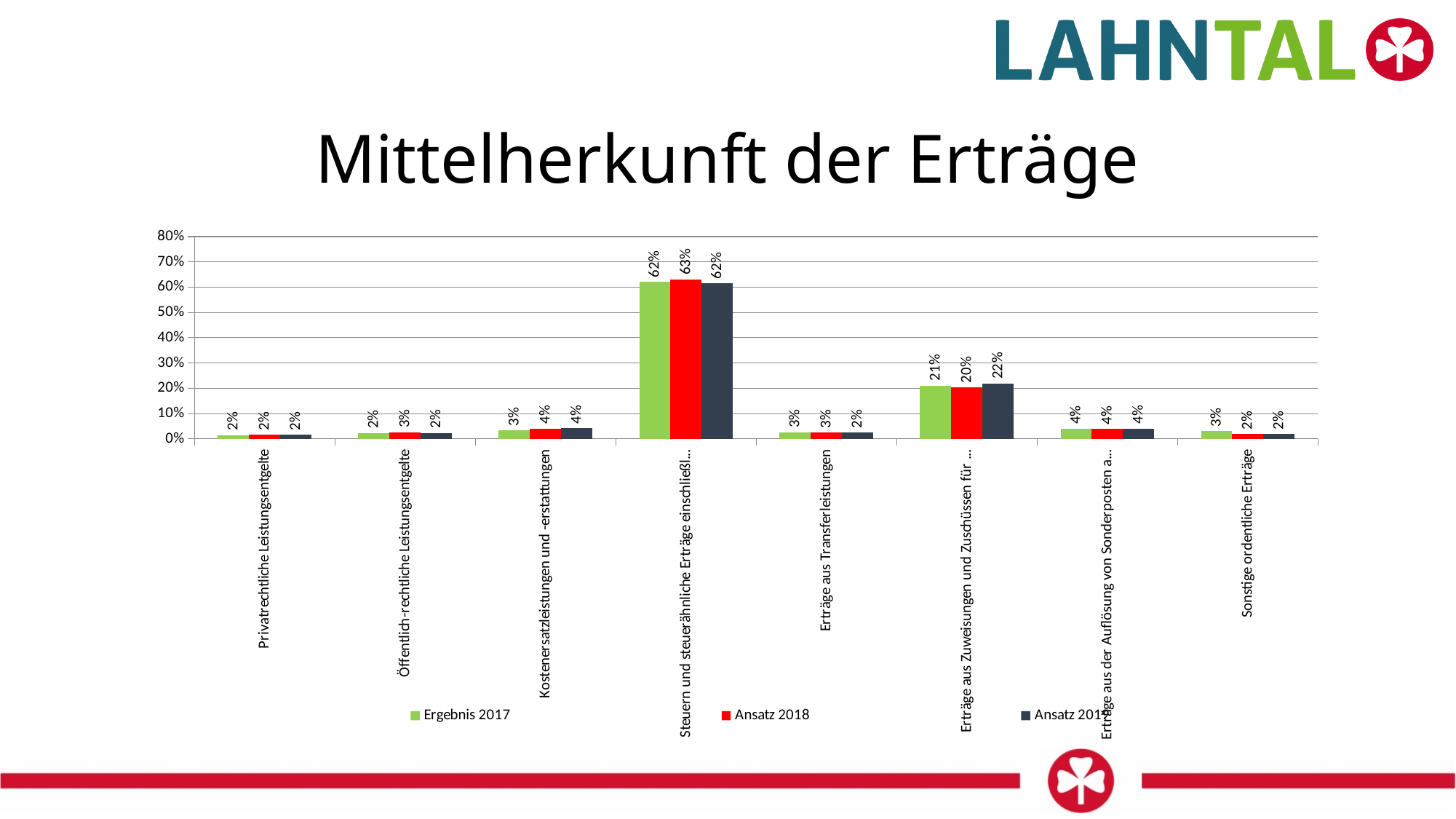
What is the Ergebnis 2017 value for Erträge aus Transferleistungen? 3% What type of chart is shown on the slide? bar chart For Sonstige ordentliche Erträge, which is larger: the Ergebnis 2017 value or the Ansatz 2018 value? Ergebnis 2017 How many series does the legend list? 3 What is the Ansatz 2018 value for Steuern und steuerähnliche Erträge? 63% Which category has the highest Ergebnis 2017 value? Steuern und steuerähnliche Erträge What is the Ansatz 2018 value for Kostenersatzleistungen und -erstattungen? 4% What is the title of the chart? Mittelherkunft der Erträge Is the Ansatz 2018 value for Erträge aus Zuweisungen und Zuschüssen greater or less than 30%? less What is the difference between the Ergebnis 2017 value for Steuern und steuerähnliche Erträge and the Ergebnis 2017 value for Erträge aus Zuweisungen und Zuschüssen? 41% How many categories are shown on the x axis? 8 What colour are the Ansatz 2018 bars? red